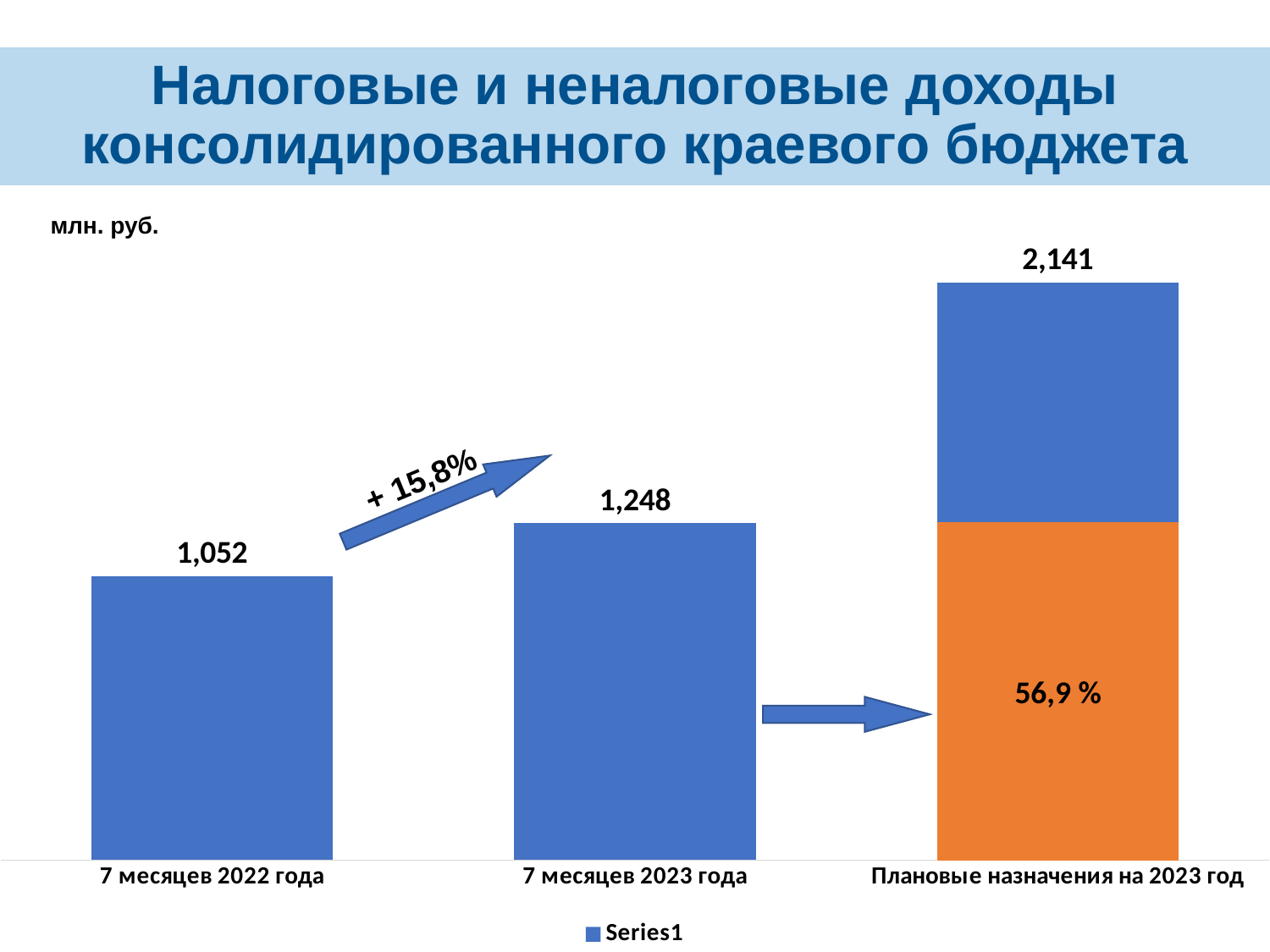
What is the value for Плановые назначения на 2023 год? 2,141 Do the values rise or fall from left to right along the x axis? rise How many categories are shown on the x axis? 3 What is the value for 7 месяцев 2023 года? 1,248 Which is larger, the value for 7 месяцев 2022 года or the value for 7 месяцев 2023 года? 7 месяцев 2023 года Which category has the lowest value? 7 месяцев 2022 года What kind of chart is shown on the slide? bar chart What is the difference between the values for Плановые назначения на 2023 год and 7 месяцев 2023 года? 893 Which category has the highest value? Плановые назначения на 2023 год What is the value for 7 месяцев 2022 года? 1,052 What is the difference between the values for 7 месяцев 2023 года and 7 месяцев 2022 года? 196 How many series does the legend list? 1